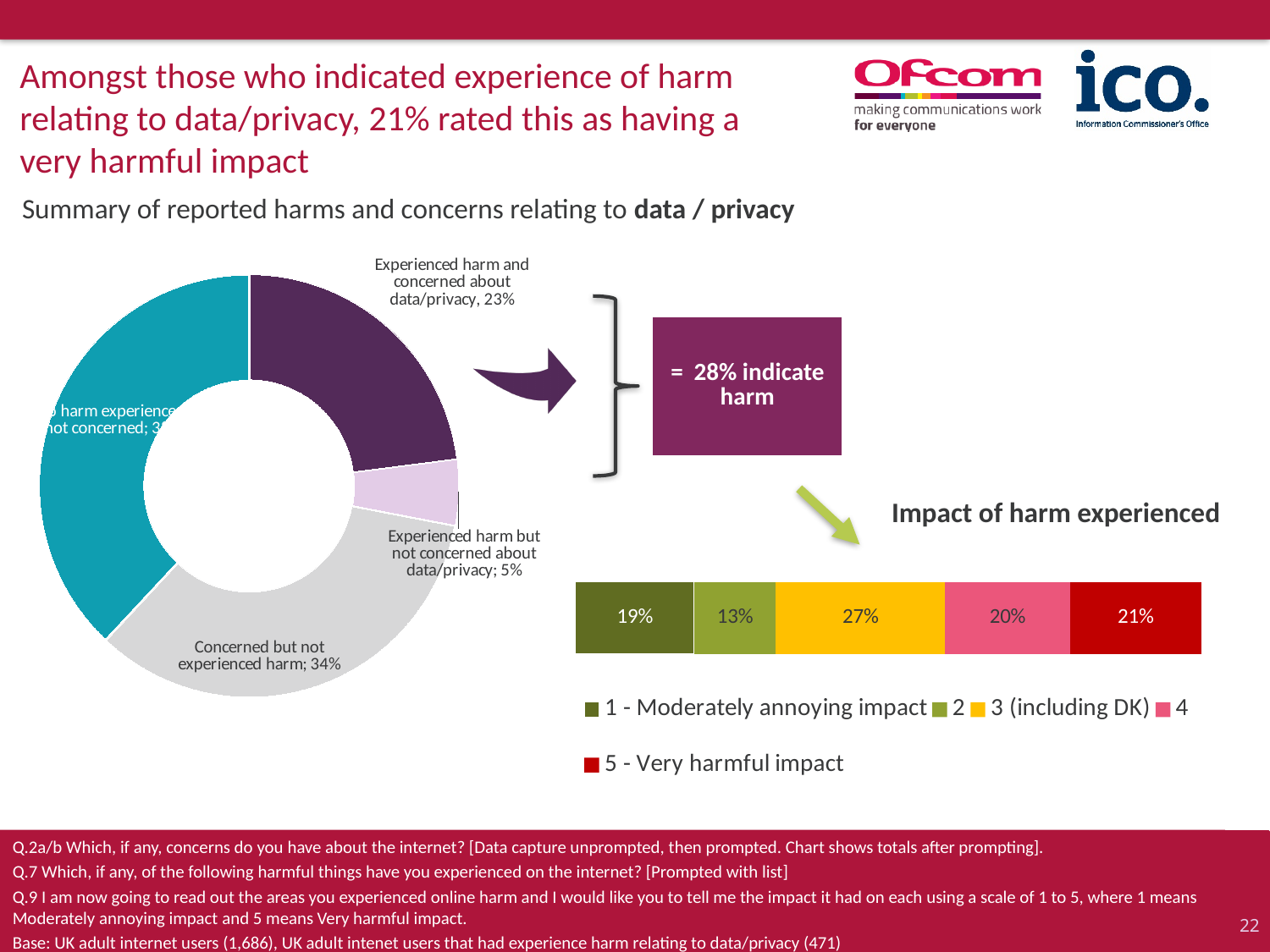
What type of chart is shown on the left of the slide? Donut (pie) chart How many series does the legend of the 'Impact of harm experienced' chart list? 5 In the donut chart on the left, what percentage experienced harm but were not concerned about data/privacy? 5% In the donut chart on the left, what percentage were concerned but had not experienced harm? 34% In the 'Impact of harm experienced' chart, what percentage rated the impact as '5 - Very harmful impact'? 21% In the 'Impact of harm experienced' chart, which rating category has the smallest share? 2 In the 'Impact of harm experienced' chart, what is the total of all the segments in the stacked bar? 100% In the donut chart on the left, how many percentage points larger is 'Concerned but not experienced harm' than 'Experienced harm and concerned about data/privacy'? 11 percentage points In the donut chart on the left, what percentage of respondents experienced harm and were concerned about data/privacy? 23% In the 'Impact of harm experienced' chart, what percentage rated the impact as '1 - Moderately annoying impact'? 19% In the 'Impact of harm experienced' chart, which rating category has the largest share? 3 (including DK) In the donut chart on the left, which labelled segment has the smallest share? Experienced harm but not concerned about data/privacy